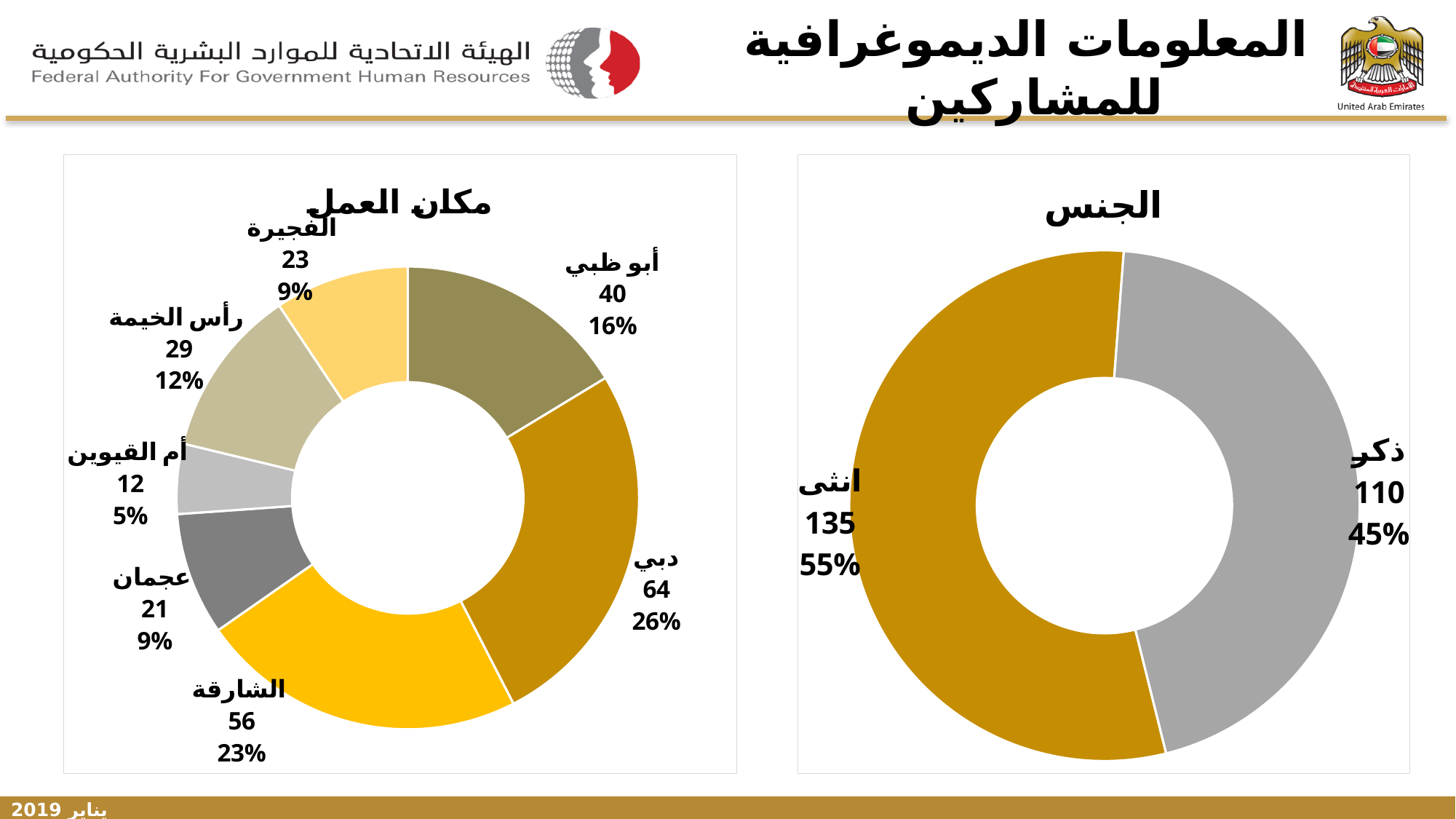
In the "الجنس" chart, what is the count for انثى? 135 In the "مكان العمل" chart, what is the count for دبي? 64 In the "الجنس" chart, what is the difference between the counts for انثى and ذكر? 25 How many categories are shown in the "مكان العمل" chart? 7 What type of chart is the "الجنس" chart? Donut (pie) chart What is the title of the chart on the right side of the slide? الجنس In the "مكان العمل" chart, what is the difference between the counts for دبي and أبو ظبي? 24 In the "مكان العمل" chart, which category has the lowest value? أم القيوين In the "الجنس" chart, what percentage share does ذكر have? 45% In the "مكان العمل" chart, what percentage share does الشارقة have? 23% In the "مكان العمل" chart, which category has the highest value? دبي In the "مكان العمل" chart, which is larger, رأس الخيمة or الفجيرة? رأس الخيمة